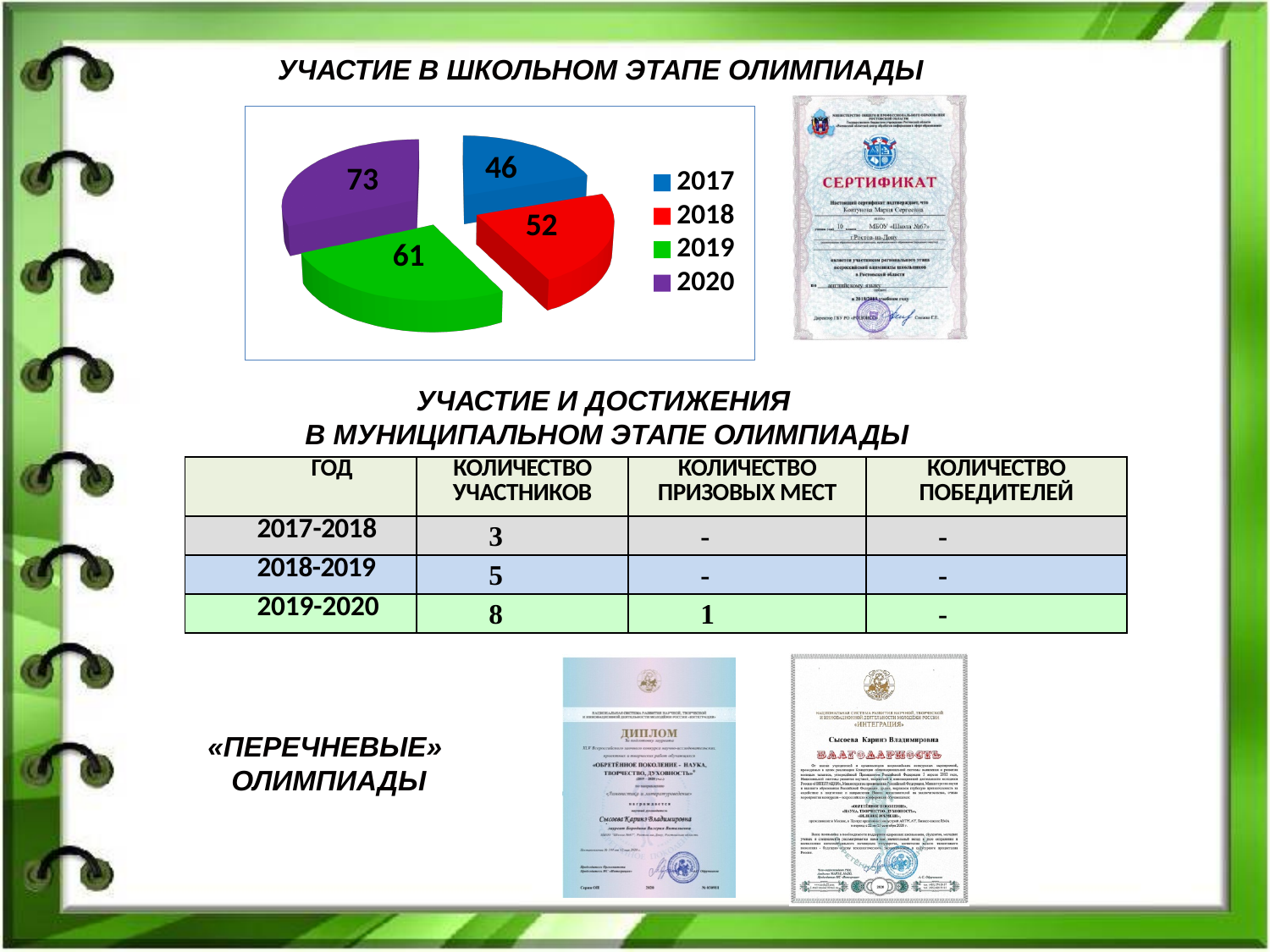
In the pie chart, what is the value for 2020? 73 In the pie chart, what is the value for 2018? 52 In the pie chart, which is larger: the value for 2018 or the value for 2019? 2019 How many years does the legend of the pie chart list? 4 In the pie chart, what is the difference between the values for 2020 and 2017? 27 Which year has the smallest slice in the pie chart? 2017 In the pie chart, what is the value for 2017? 46 What colour is the slice for 2019 in the pie chart? Green Which year has the largest slice in the pie chart? 2020 What type of chart is shown under the title 'УЧАСТИЕ В ШКОЛЬНОМ ЭТАПЕ ОЛИМПИАДЫ'? Pie chart In the pie chart, what is the value for 2019? 61 In the pie chart, what is the difference between the values for 2019 and 2018? 9